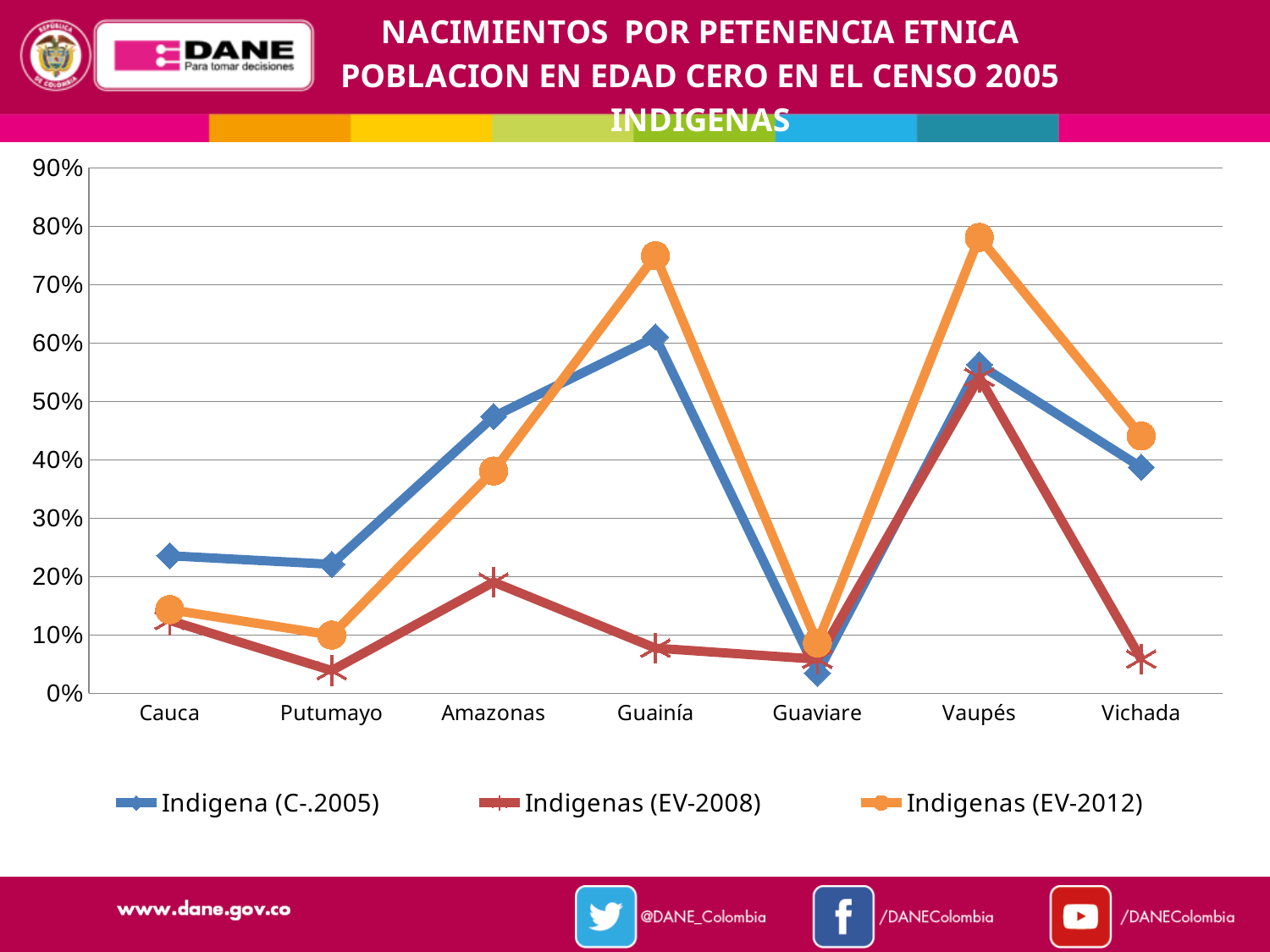
How many departments are shown along the x axis? 7 How many series does the legend list? 3 Which department has the highest value for the Indigena (C-.2005) series? Guainía Does the Indigenas (EV-2012) series rise or fall from Putumayo to Guainía? rise Is the Indigenas (EV-2008) value for Vaupés greater or less than 50%? greater For Guainía, which series has the larger value: Indigena (C-.2005) or Indigenas (EV-2012)? Indigenas (EV-2012) Is the Indigenas (EV-2012) value for Guainía greater or less than 70%? greater Which department has the highest value for the Indigenas (EV-2008) series? Vaupés For Cauca, which series has the larger value: Indigena (C-.2005) or Indigenas (EV-2012)? Indigena (C-.2005) What kind of chart is shown on the slide? line chart Which department has the lowest value for the Indigena (C-.2005) series? Guaviare Is the Indigena (C-.2005) value for Amazonas greater or less than 50%? less